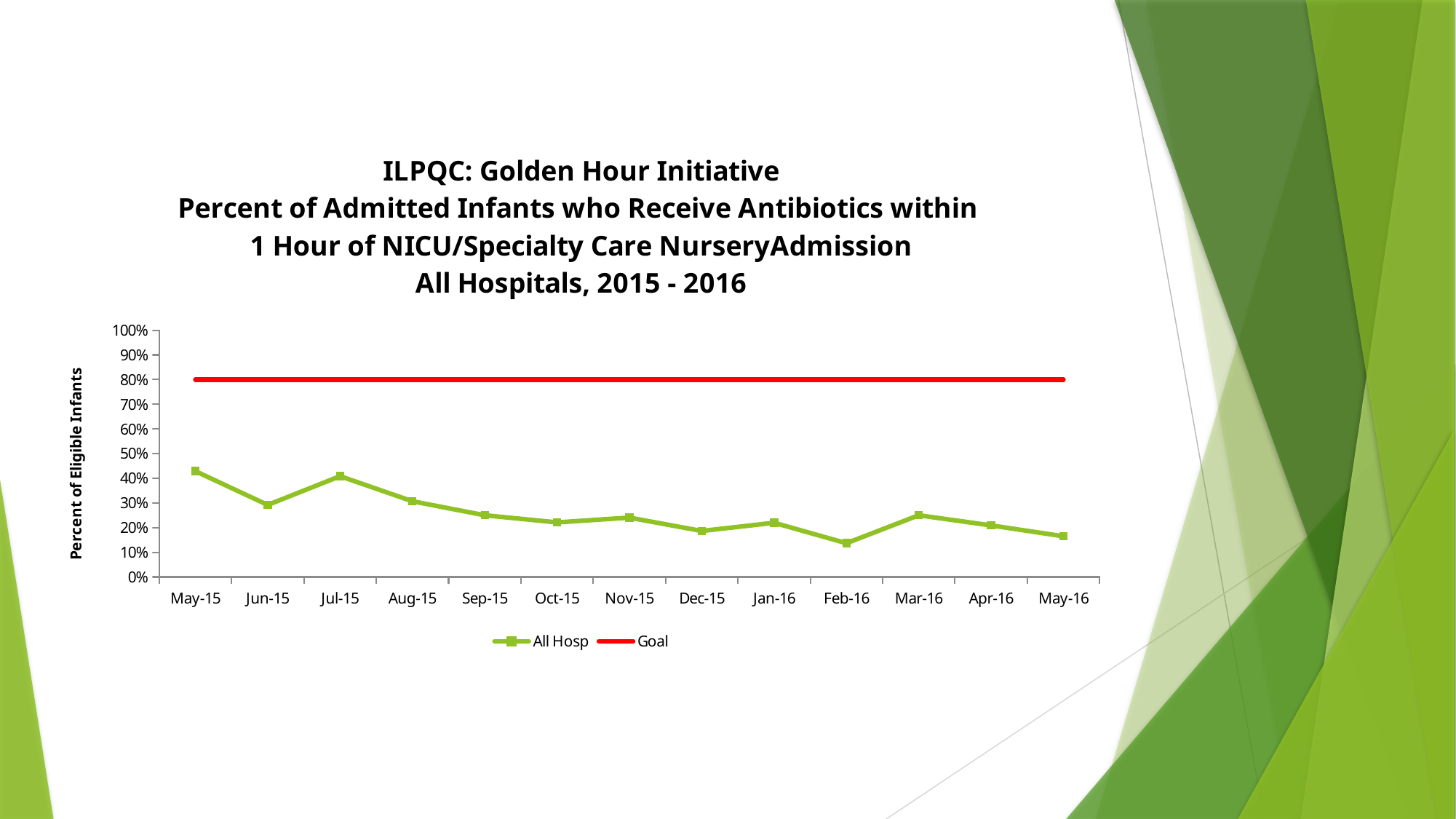
Is the All Hosp value for May-15 greater or less than 40%? greater Is the All Hosp value for Sep-15 greater or less than 30%? less Is the All Hosp value for Mar-16 greater or less than 20%? greater Which is larger for All Hosp, the value for May-15 or the value for Jun-15? May-15 What is the value of the Goal line? 80% How many series does the legend list? 2 Does the All Hosp line generally rise or fall from May-15 to May-16? Fall How many months are plotted along the x axis? 13 Which is larger for All Hosp, the value for Feb-16 or the value for Mar-16? Mar-16 What is the label on the vertical axis? Percent of Eligible Infants What kind of chart is shown on the slide? Line chart